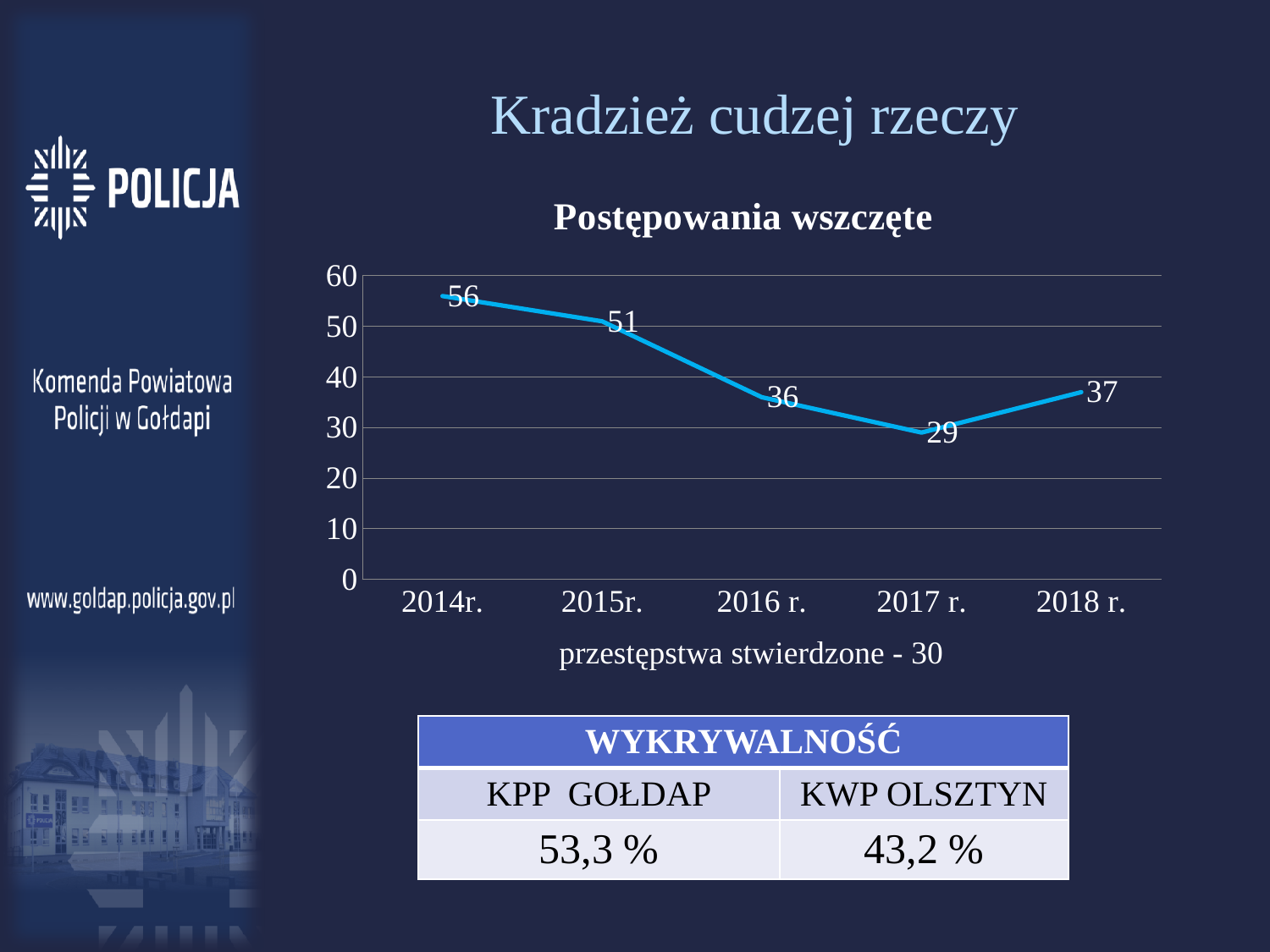
What kind of chart is the Postępowania wszczęte chart? line chart Which year has the lowest value in the Postępowania wszczęte chart? 2017 r. How many years are plotted in the Postępowania wszczęte chart? 5 What is the difference between the values for 2016 r. and 2017 r. in the Postępowania wszczęte chart? 7 What is the difference between the values for 2014r. and 2015r. in the Postępowania wszczęte chart? 5 What is the title of the chart on the slide? Postępowania wszczęte Which is larger in the Postępowania wszczęte chart, the value for 2016 r. or 2018 r.? 2018 r. What is the value for 2017 r. in the Postępowania wszczęte chart? 29 Is the value for 2015r. in the Postępowania wszczęte chart greater or less than 40? greater What is the value for 2018 r. in the Postępowania wszczęte chart? 37 Which year has the highest value in the Postępowania wszczęte chart? 2014r. What is the value for 2014r. in the Postępowania wszczęte chart? 56